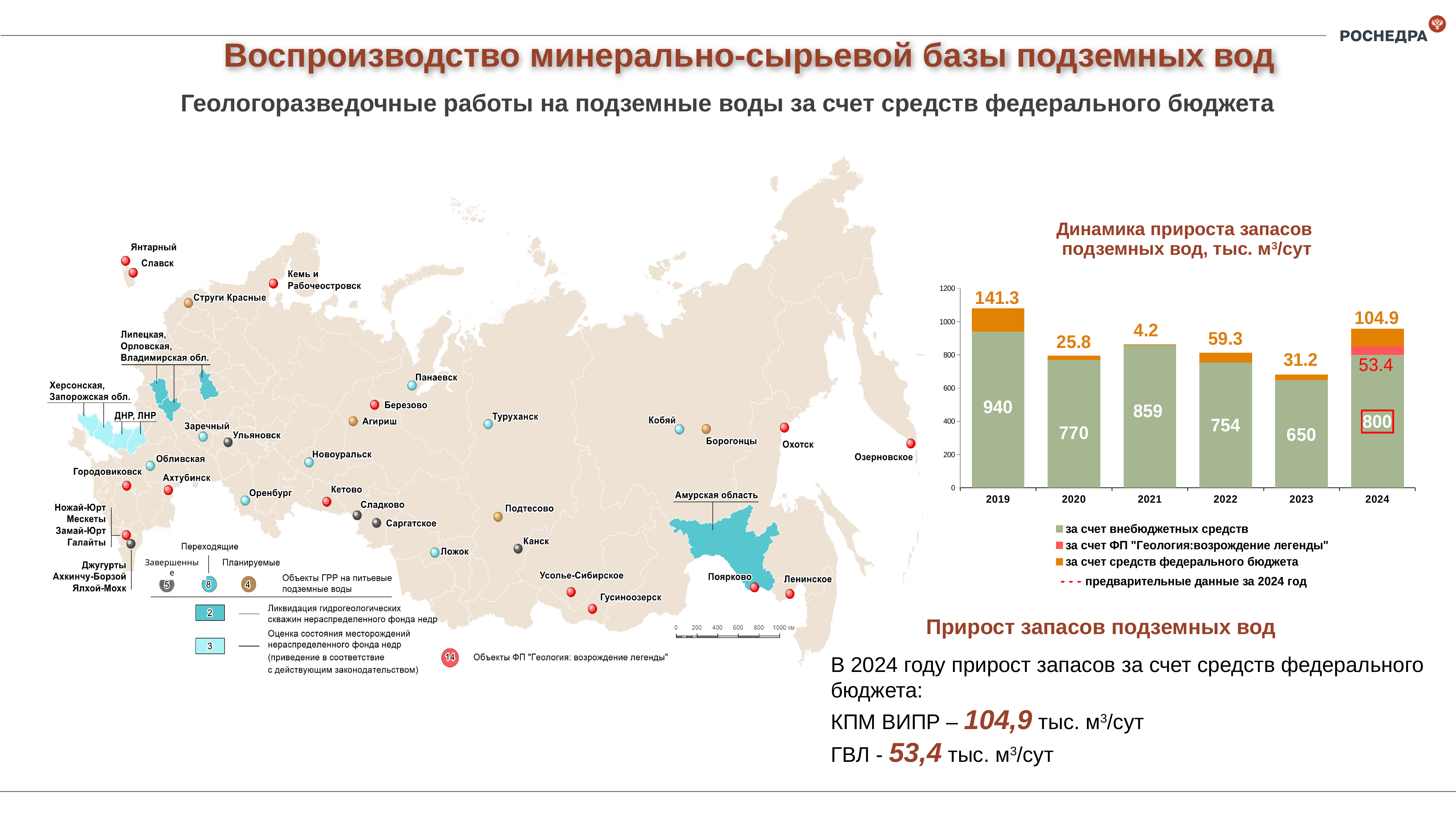
What kind of chart is 'Динамика прироста запасов подземных вод'? Stacked bar chart In the chart 'Динамика прироста запасов подземных вод', what is the value for 'за счет внебюджетных средств' in 2023? 650 In the chart 'Динамика прироста запасов подземных вод', what is the total of the stacked bar for 2024? 958.3 In the chart 'Динамика прироста запасов подземных вод', what is the difference between the 'за счет внебюджетных средств' values for 2019 and 2023? 290 In the chart 'Динамика прироста запасов подземных вод', is the total height of the 2019 bar greater or less than 1000? greater In the chart 'Динамика прироста запасов подземных вод', which year has the highest value for 'за счет внебюджетных средств'? 2019 In the chart 'Динамика прироста запасов подземных вод', what is the value for 'за счет средств федерального бюджета' in 2024? 104.9 In the chart 'Динамика прироста запасов подземных вод', what is the value for 'за счет ФП "Геология:возрождение легенды"' in 2024? 53.4 In the chart 'Динамика прироста запасов подземных вод', which year has the lowest value for 'за счет средств федерального бюджета'? 2021 In the chart 'Динамика прироста запасов подземных вод', which year has the larger 'за счет внебюджетных средств' value, 2021 or 2022? 2021 How many years are shown on the x axis of the chart 'Динамика прироста запасов подземных вод'? 6 In the chart 'Динамика прироста запасов подземных вод', what is the value for 'за счет внебюджетных средств' in 2019? 940